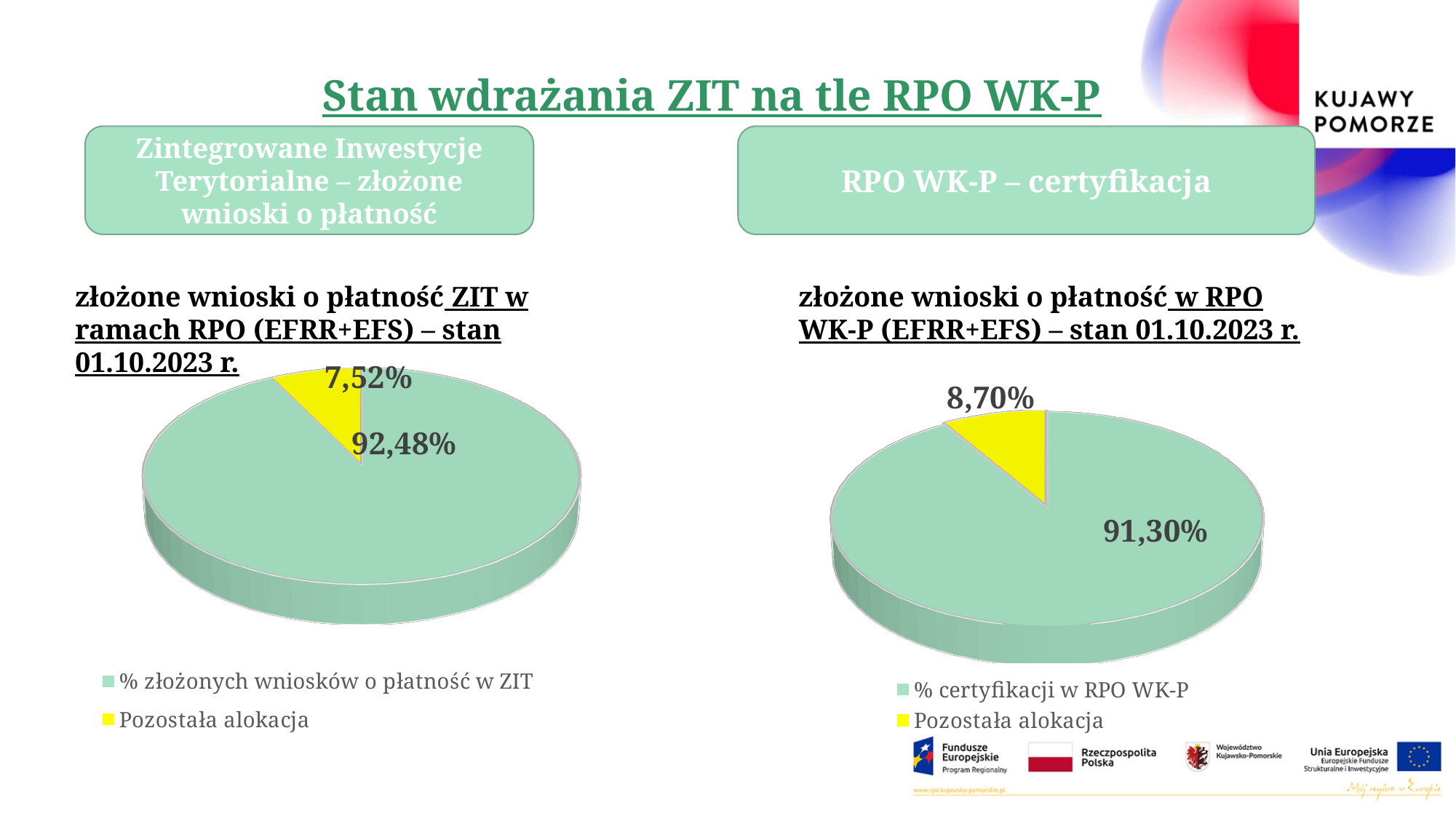
In the left pie chart, what share is labelled for '% złożonych wniosków o płatność w ZIT'? 92,48% In the right pie chart, what share is labelled for 'Pozostała alokacja'? 8,70% What is the difference between the 'Pozostała alokacja' share in the right pie chart and in the left pie chart? 1,18 percentage points Which is larger: the 'Pozostała alokacja' share in the left pie chart or in the right pie chart? Right pie chart (8,70%) What type of chart is shown on the left side of the slide? Pie chart In the right pie chart, what share is labelled for '% certyfikacji w RPO WK-P'? 91,30% What colour is the 'Pozostała alokacja' slice in both pie charts? Yellow How many slices does the right pie chart have? 2 In the right pie chart, which slice is the smallest? Pozostała alokacja In the left pie chart, what share is labelled for 'Pozostała alokacja'? 7,52% How many entries does the legend of the left pie chart list? 2 In the left pie chart, which slice is the largest? % złożonych wniosków o płatność w ZIT